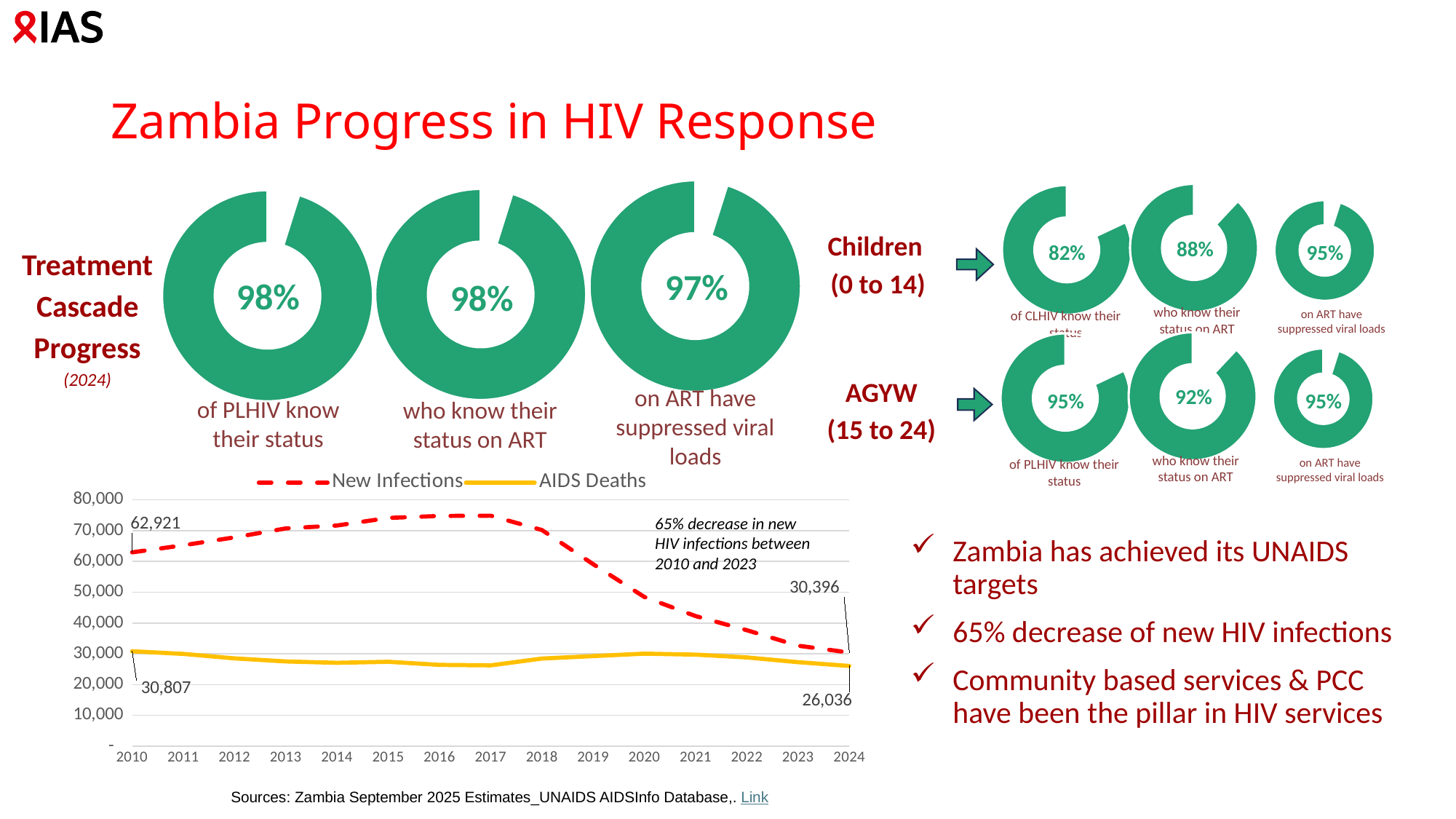
In the line chart, what was the value for New Infections in 2010? 62,921 In the line chart, what was the value for AIDS Deaths in 2024? 26,036 In the Children (0 to 14) donut charts, what percentage of CLHIV know their status? 82% In the line chart, what was the value for New Infections in 2024? 30,396 In the line chart, how many series does the legend list? 2 In the line chart, is the value for New Infections in 2017 greater or less than 70,000? greater In the line chart, what was the value for AIDS Deaths in 2010? 30,807 In the Treatment Cascade Progress (2024) donut charts, what percentage of people on ART have suppressed viral loads? 97% In the line chart, by how much did New Infections fall between 2010 and 2024? 32,525 In the line chart, which series has the larger value in 2024, New Infections or AIDS Deaths? New Infections In the line chart, in which year did New Infections reach their highest point? 2017 What kind of chart shows New Infections and AIDS Deaths over time? line chart